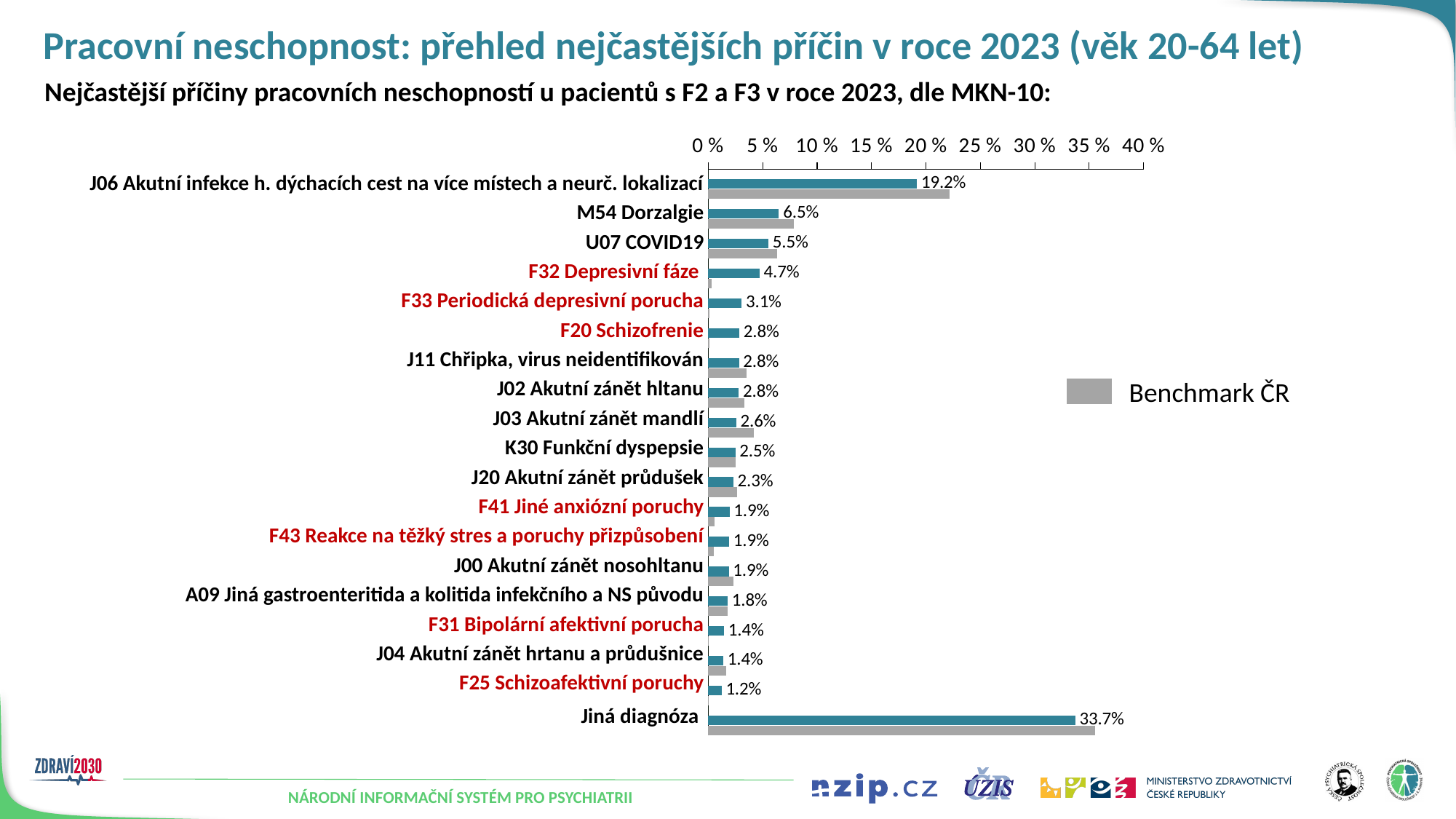
What is the labelled value for M54 Dorzalgie? 6.5% Which category has the highest labelled value? Jiná diagnóza What is the labelled value for U07 COVID19? 5.5% What is the labelled value for F32 Depresivní fáze? 4.7% Which category has the lowest labelled value? F25 Schizoafektivní poruchy What kind of chart is shown on the slide? bar chart Is the Benchmark ČR value for J06 Akutní infekce h. dýchacích cest greater or less than 20 %? greater Which has the larger labelled value, F33 Periodická depresivní porucha or F20 Schizofrenie? F33 Periodická depresivní porucha What is the labelled value for J06 Akutní infekce h. dýchacích cest na více místech a neurč. lokalizací? 19.2% What is the difference between the labelled values for J06 Akutní infekce h. dýchacích cest and M54 Dorzalgie? 12.7% What series name is shown in the chart legend? Benchmark ČR How many diagnosis categories are shown on the chart? 19